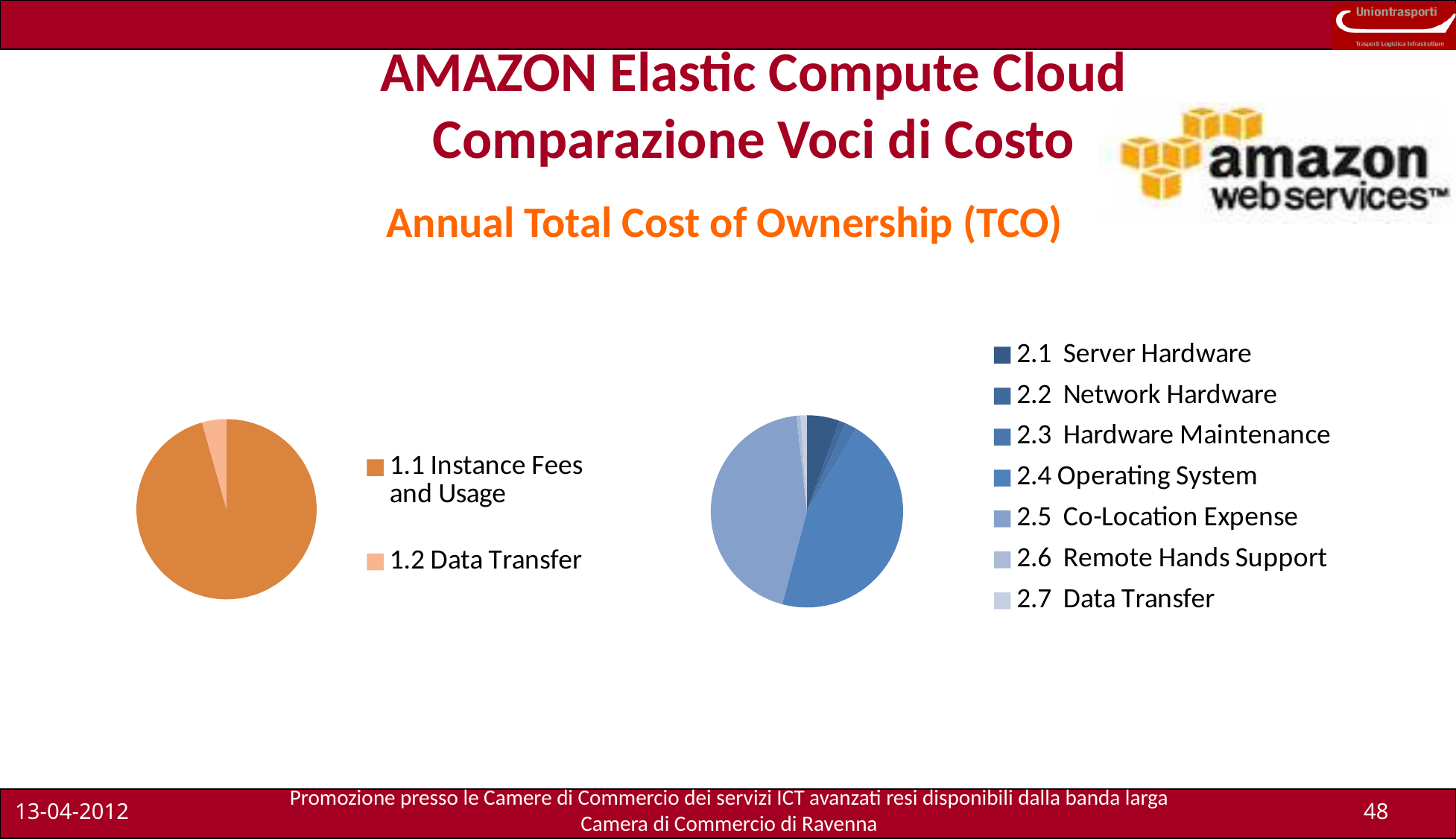
How many categories does the right pie chart show? 7 What is the orange subtitle shown above the charts? Annual Total Cost of Ownership (TCO) How many categories does the left pie chart show? 2 In the right pie chart, which is larger: 2.4 Operating System or 2.1 Server Hardware? 2.4 Operating System In the right pie chart's legend, which category is listed first? 2.1 Server Hardware In the left pie chart, which is larger: 1.1 Instance Fees and Usage or 1.2 Data Transfer? 1.1 Instance Fees and Usage In the left pie chart, does 1.1 Instance Fees and Usage take up more or less than half of the pie? more What kind of chart is the right chart on the slide? Pie chart In the left pie chart, which category has the smallest slice? 1.2 Data Transfer In the left pie chart, which category has the largest slice? 1.1 Instance Fees and Usage What kind of chart is the left chart on the slide? Pie chart In the right pie chart, which is larger: 2.5 Co-Location Expense or 2.7 Data Transfer? 2.5 Co-Location Expense